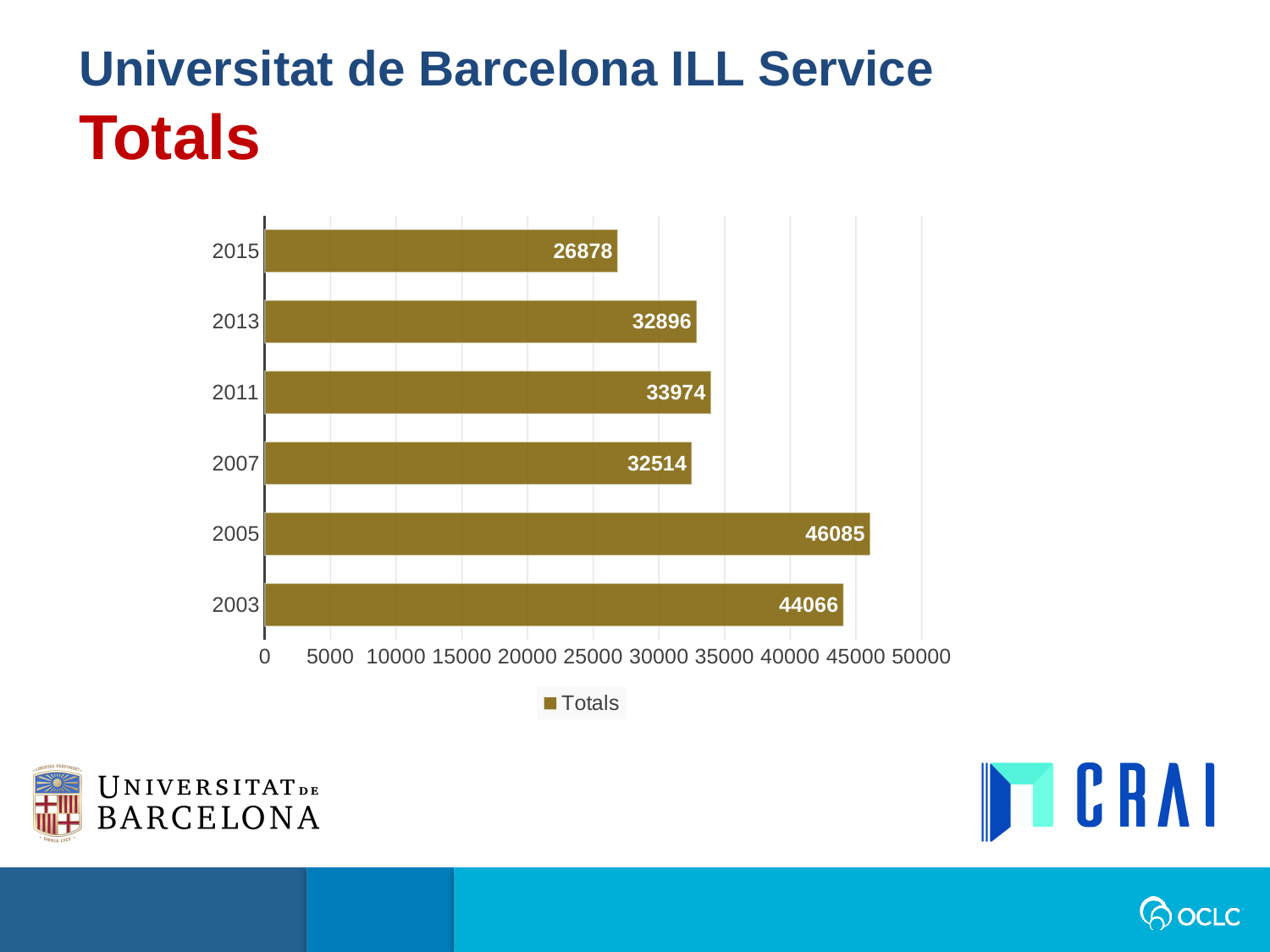
What is the value for 2015? 26878 What kind of chart is shown on the slide? bar chart Which is larger, the value for 2003 or the value for 2013? 2003 What is the difference between the values for 2011 and 2015? 7096 Which year has the highest value? 2005 Is the value for 2011 greater or less than 30000? greater What is the difference between the values for 2005 and 2003? 2019 How many years are shown in the chart? 6 What is the value for 2005? 46085 What is the value for 2007? 32514 Which year has the lowest value? 2015 What series name does the legend show? Totals